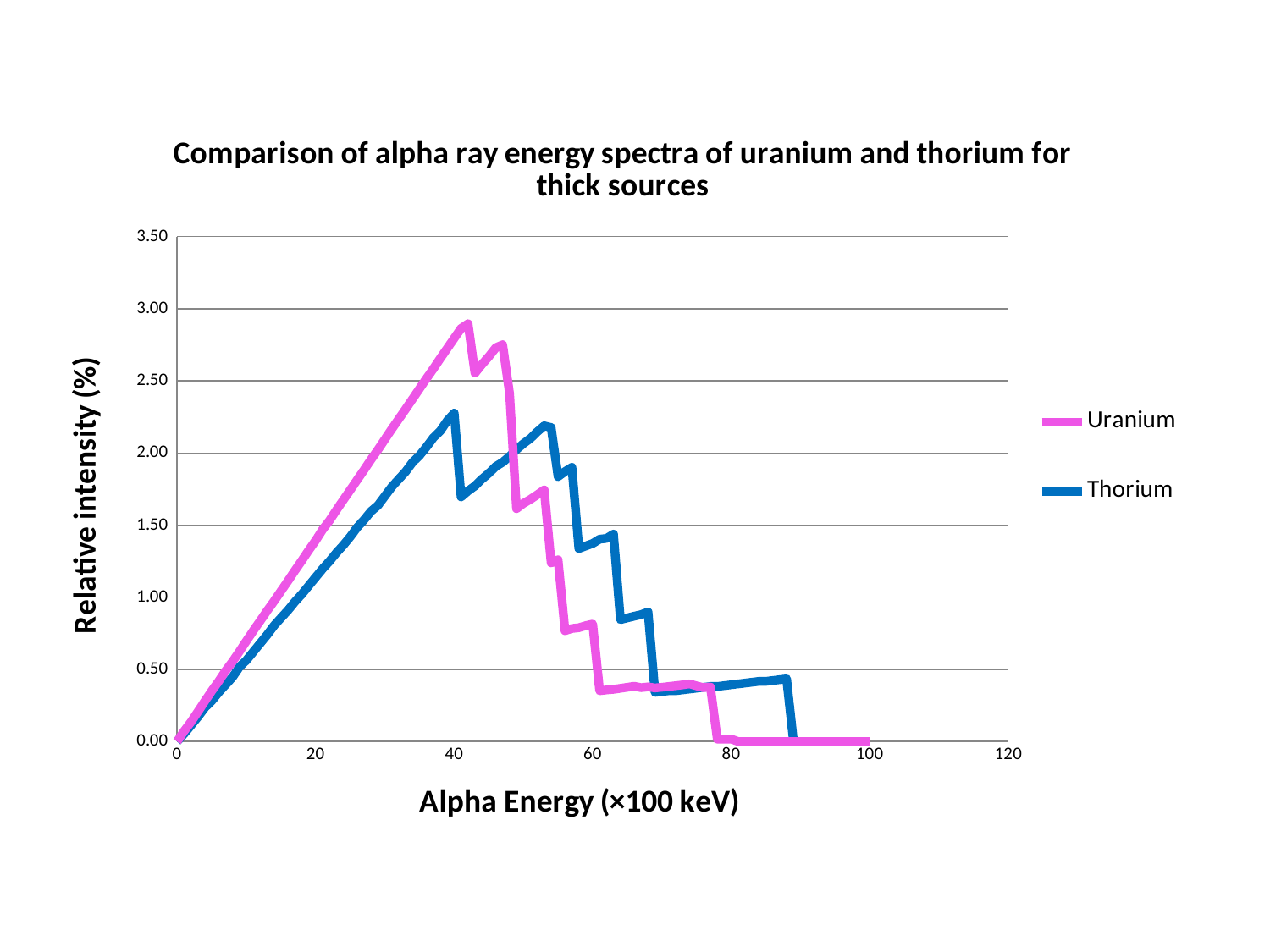
What is the title of the chart? Comparison of alpha ray energy spectra of uranium and thorium for thick sources Is the Thorium value at an alpha energy of 60 greater or less than 1.00? greater Which series drops to a relative intensity of 0.00 at a lower alpha energy, Uranium or Thorium? Uranium Is the Uranium value at an alpha energy of 60 greater or less than 1.00? less What kind of chart is shown on the slide? line chart How does the Uranium series change as alpha energy increases from 0 to 40? rises How many series does the legend list? 2 Is the peak value of the Uranium series greater or less than 2.50? greater Which series is drawn in magenta? Uranium Which series reaches the higher peak relative intensity, Uranium or Thorium? Uranium At an alpha energy of 60, which series has the larger relative intensity, Uranium or Thorium? Thorium